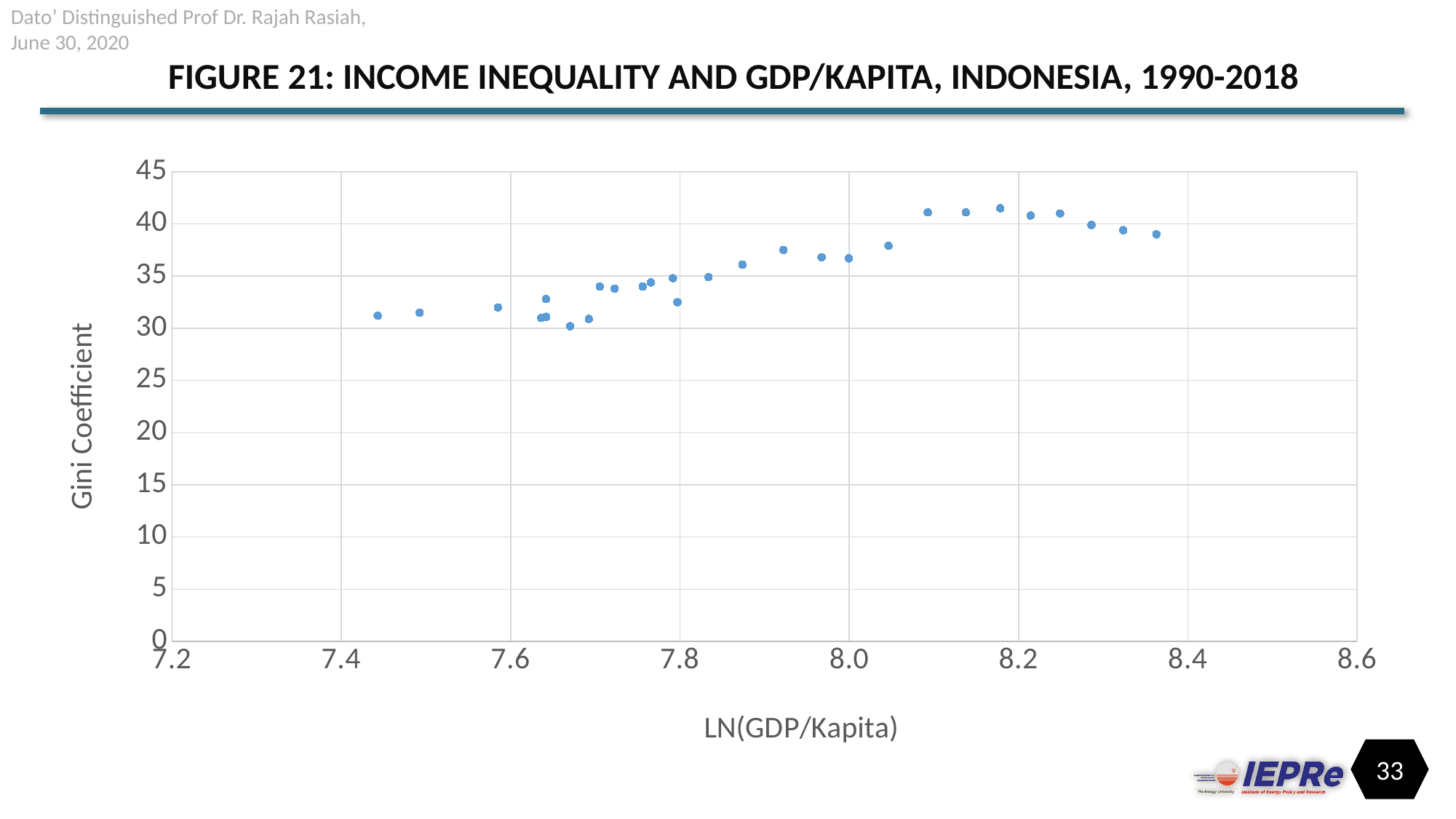
What kind of chart is shown on the slide? scatter plot Is the highest Gini Coefficient value plotted greater or less than 40? greater Is the Gini Coefficient of the point with the largest LN(GDP/Kapita) greater or less than 35? greater Is the Gini Coefficient of the point with the smallest LN(GDP/Kapita) greater or less than 30? greater Do the Gini Coefficient values generally rise or fall as LN(GDP/Kapita) increases along the x axis? rise What is the label of the vertical axis? Gini Coefficient What is the maximum value shown on the vertical axis? 45 What is the title of the chart? FIGURE 21: INCOME INEQUALITY AND GDP/KAPITA, INDONESIA, 1990-2018